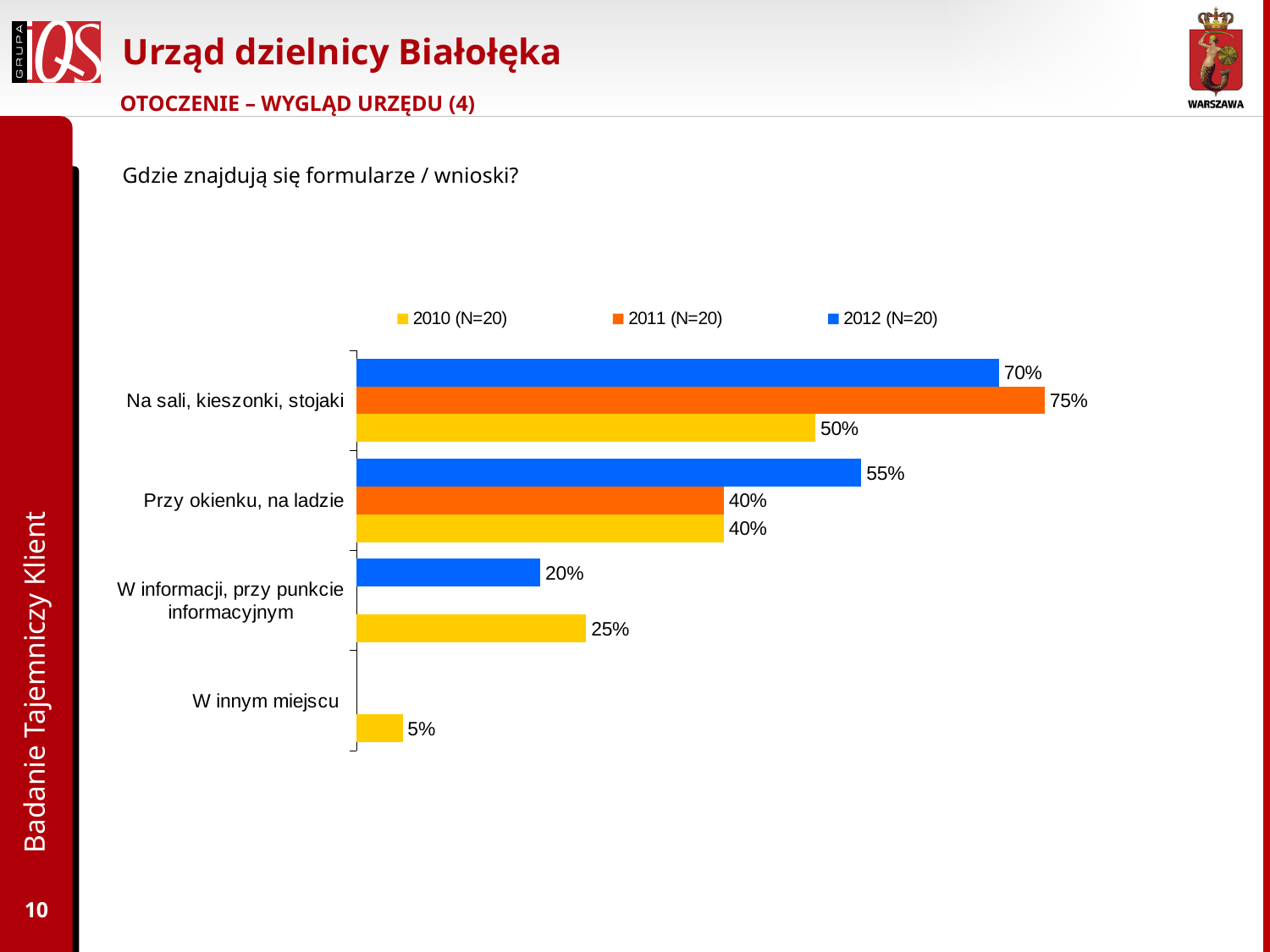
What is the value for 'W informacji, przy punkcie informacyjnym' in the 2010 (N=20) series? 25% How many series does the legend list? 3 Which category has the highest value in the 2012 (N=20) series? Na sali, kieszonki, stojaki What kind of chart is shown on the slide? bar chart For 'Przy okienku, na ladzie', which is larger: the 2012 (N=20) value or the 2011 (N=20) value? 2012 (N=20) What is the value for 'W innym miejscu' in the 2010 (N=20) series? 5% How many categories are shown on the chart? 4 What is the value for 'Na sali, kieszonki, stojaki' in the 2011 (N=20) series? 75% What is the value for 'Przy okienku, na ladzie' in the 2012 (N=20) series? 55% Which category has the lowest value in the 2010 (N=20) series? W innym miejscu What is the difference between the 2011 (N=20) and 2010 (N=20) values for 'Na sali, kieszonki, stojaki'? 25% What colour are the bars for the 2011 (N=20) series? orange